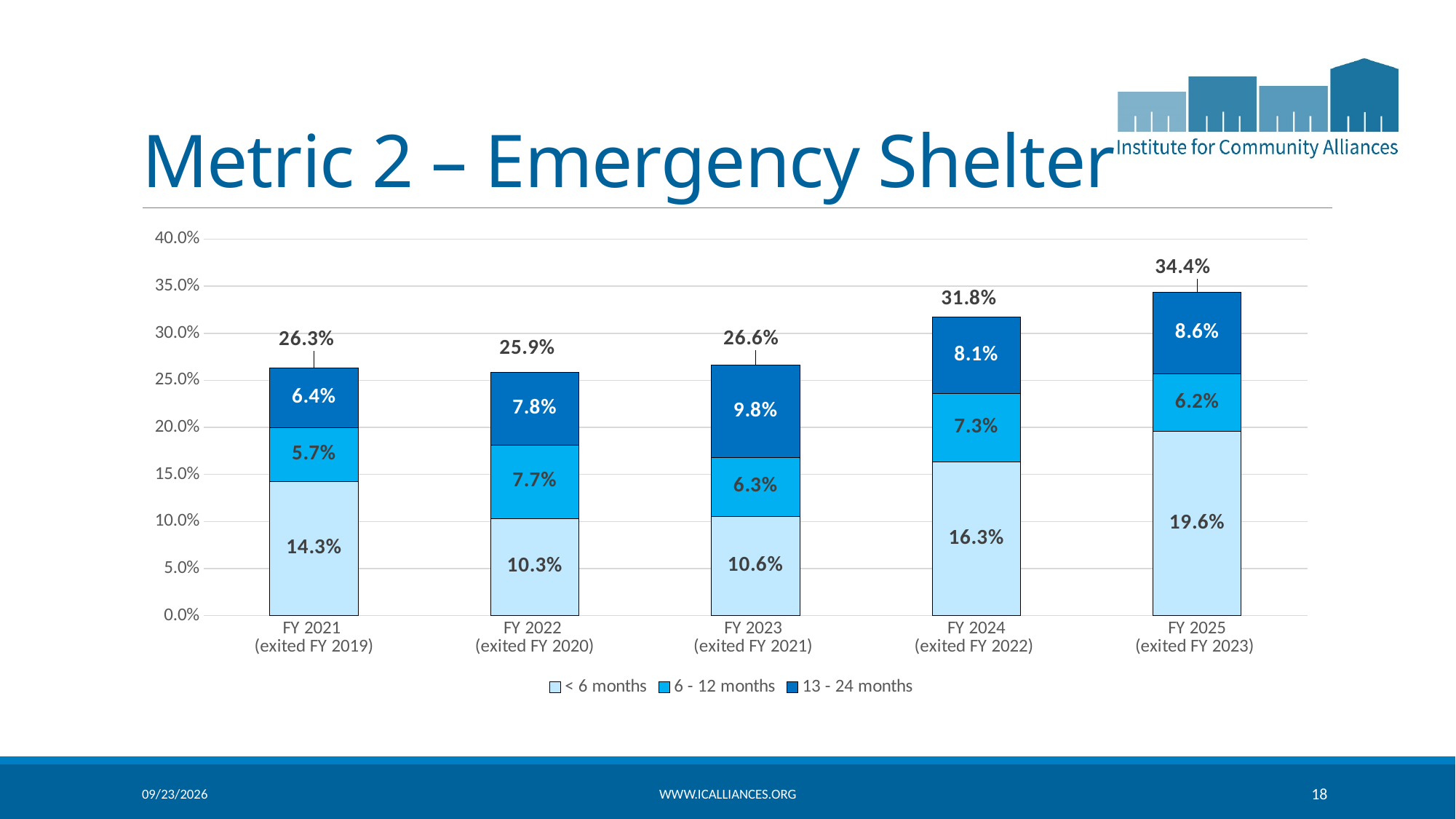
How many fiscal years are shown on the x axis? 5 What is the value for '< 6 months' in FY 2021 (exited FY 2019)? 14.3% Which fiscal year has the lowest total? FY 2022 (exited FY 2020) What kind of chart is shown on the slide? Stacked bar chart How many series does the legend list? 3 Which fiscal year has the highest total? FY 2025 (exited FY 2023) Which is larger: the '13 - 24 months' value for FY 2022 or for FY 2021? FY 2022 What is the value for '13 - 24 months' in FY 2023 (exited FY 2021)? 9.8% What is the total of the stacked bar for FY 2025 (exited FY 2023)? 34.4% What is the difference between the '< 6 months' values for FY 2025 and FY 2024? 3.3% Do the total values rise or fall from FY 2023 to FY 2025? Rise What is the value for '6 - 12 months' in FY 2024 (exited FY 2022)? 7.3%